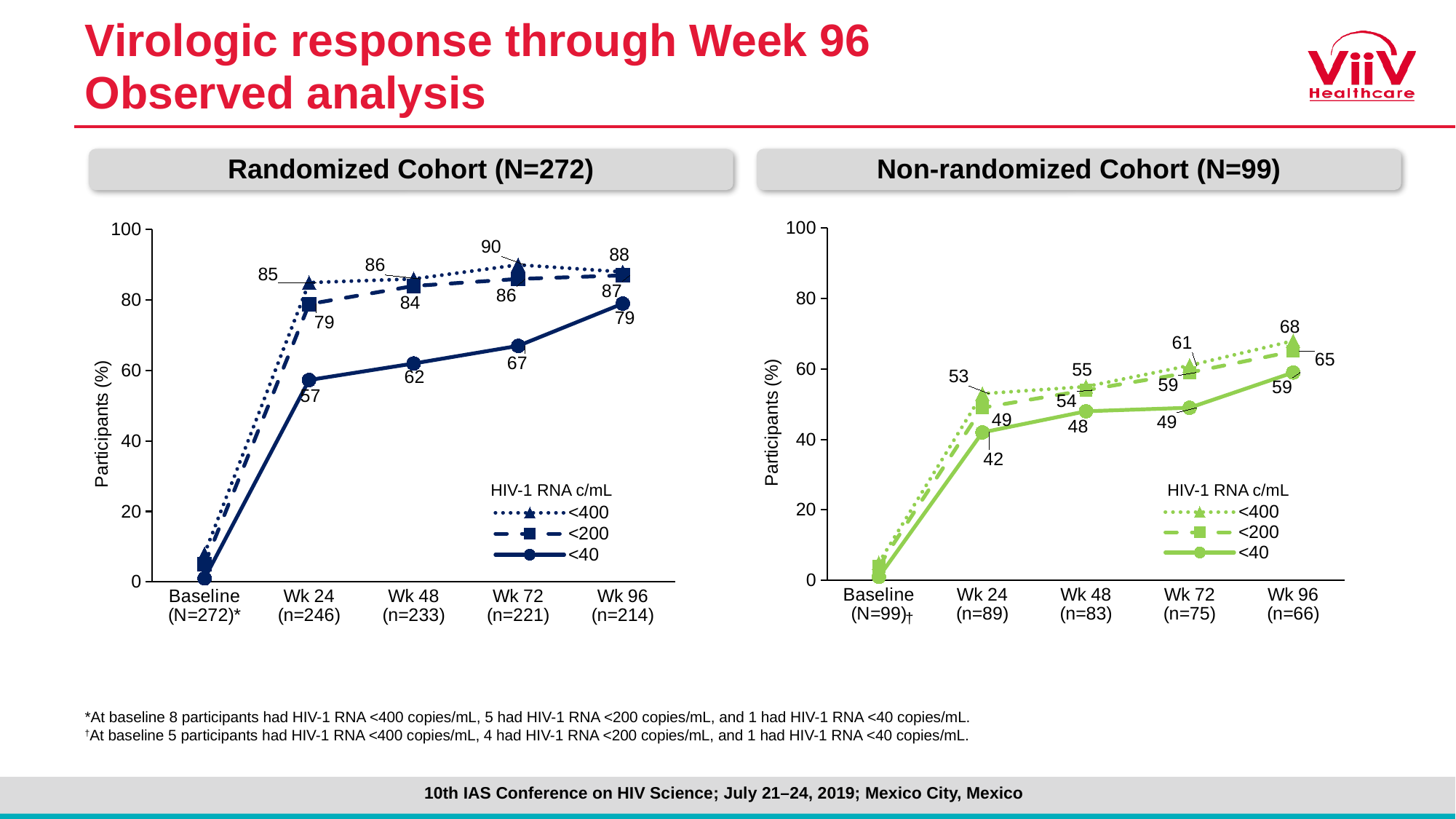
How many series does the legend list in the Non-randomized Cohort chart? 3 In the Non-randomized Cohort chart, what is the difference between the <400 values at Wk 96 and Wk 24? 15 In the Randomized Cohort chart, at which time point does the <400 series reach its highest value? Wk 72 In the Randomized Cohort chart, is the <40 value at Wk 48 larger or smaller than the <200 value at Wk 48? smaller In the Randomized Cohort chart, what is the difference between the <400 and <40 values at Wk 24? 28 In the Non-randomized Cohort chart, which series has the lowest value at Wk 96? <40 In the Randomized Cohort chart, what is the value for the <400 series at Wk 72? 90 In the Non-randomized Cohort chart, what is the value for the <40 series at Wk 24? 42 In the Randomized Cohort chart, what is the value for the <40 series at Wk 96? 79 What kind of chart is the Randomized Cohort chart? line chart In the Non-randomized Cohort chart, what is the value for the <200 series at Wk 48? 54 In the Non-randomized Cohort chart, does the <40 series rise or fall from Wk 24 to Wk 96? rise